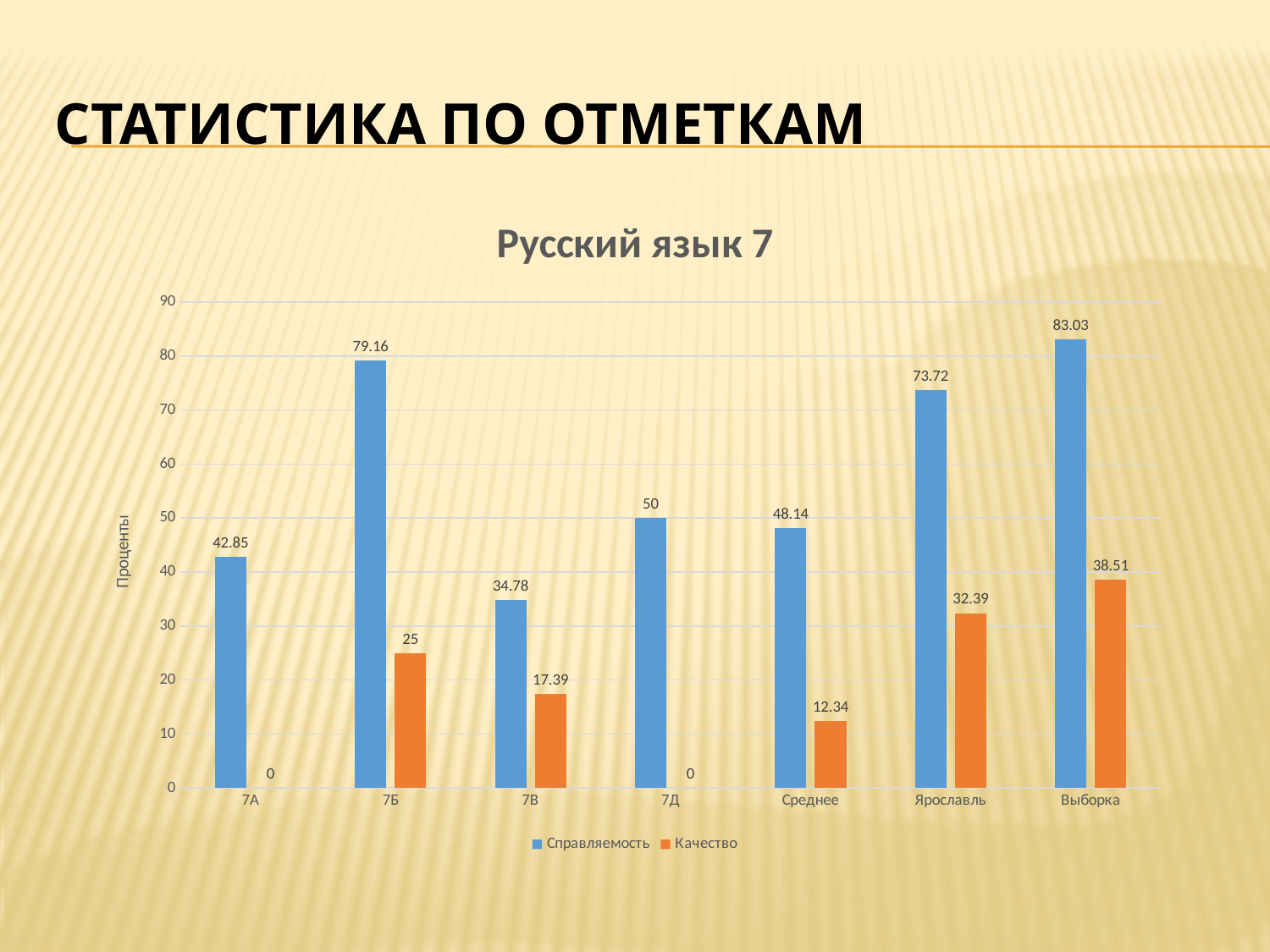
Is the Справляемость value for Ярославль greater or less than 70? greater What is the Качество value for 7Д? 0 What kind of chart is shown on the slide? bar chart How many categories are shown on the x axis? 7 Which category has the highest Справляемость value? Выборка Which category has the lowest Справляемость value? 7В What is the difference between the Справляемость and Качество values for Выборка? 44.52 What is the title of the chart? Русский язык 7 How many series does the legend list? 2 What is the Справляемость value for 7Б? 79.16 Which is larger, the Справляемость value for 7Д or for Среднее? 7Д What is the Качество value for Ярославль? 32.39